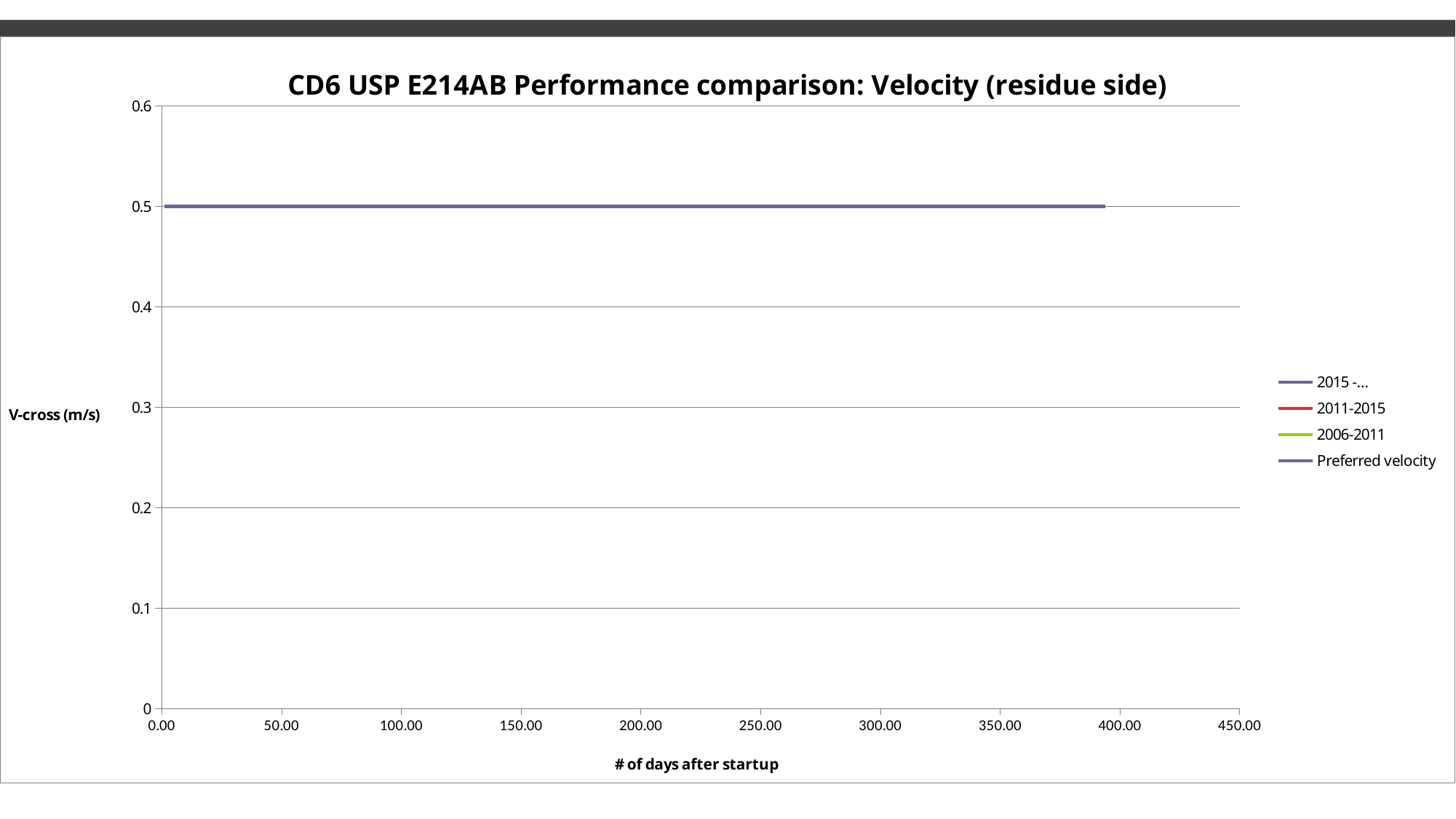
Is the value of the Preferred velocity line greater or less than 0.4? greater How many series does the legend list? 4 What is the highest value shown on the x axis? 450.00 What is the title of the chart? CD6 USP E214AB Performance comparison: Velocity (residue side) Does the Preferred velocity line rise, fall, or stay flat as the number of days after startup increases? stays flat What is the highest value shown on the y axis? 0.6 What value does the Preferred velocity line sit at on the y axis? 0.5 What kind of chart is shown on the slide? line chart What is the label of the y axis? V-cross (m/s) Is the value of the Preferred velocity line greater or less than 0.6? less